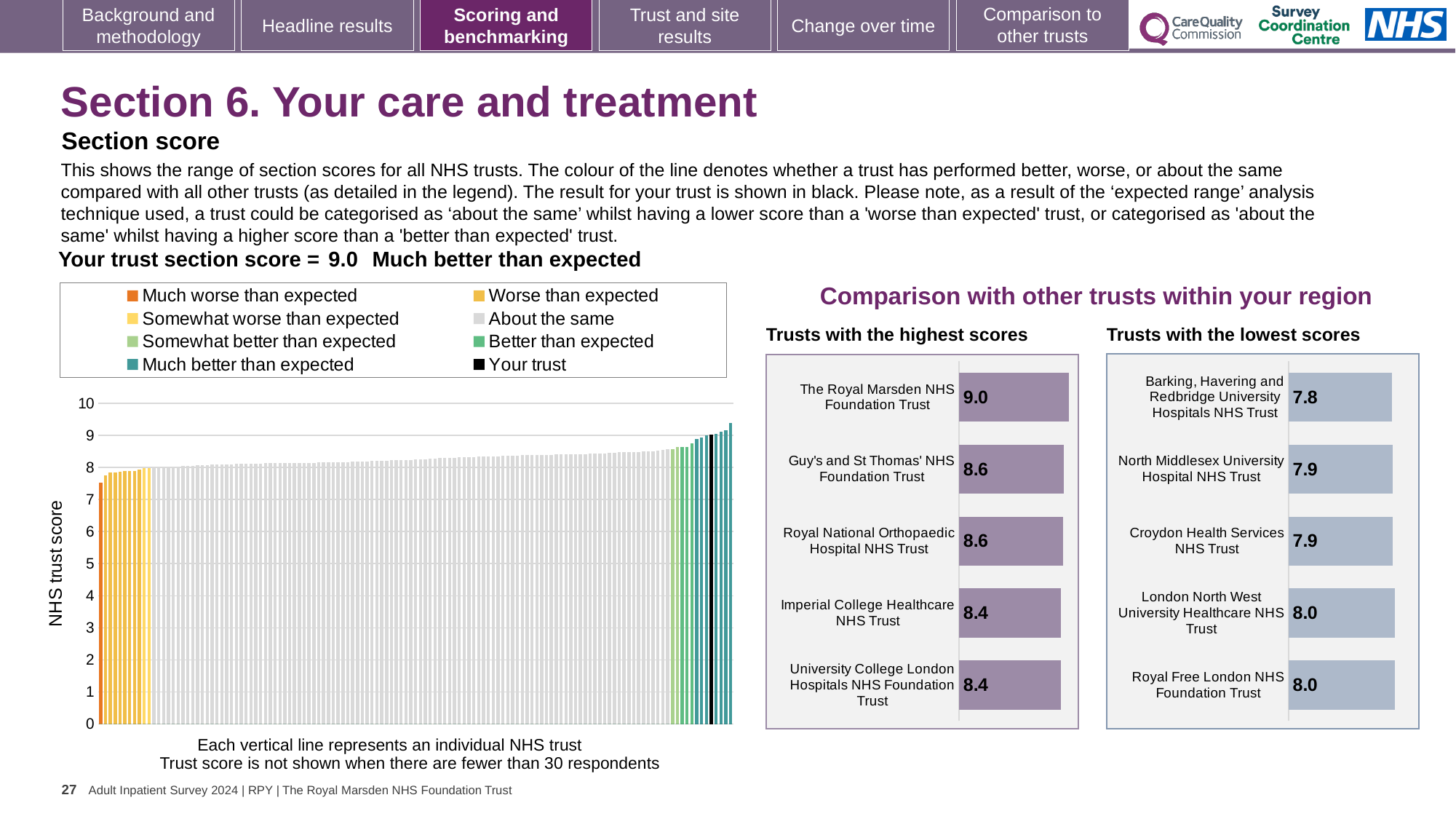
In the 'Trusts with the lowest scores' chart, what is the score for Royal Free London NHS Foundation Trust? 8.0 How many trusts are shown in the 'Trusts with the highest scores' chart? 5 How many entries does the legend of the 'NHS trust score' chart list? 8 In the 'Trusts with the highest scores' chart, what is the score for Imperial College Healthcare NHS Trust? 8.4 In the 'Trusts with the highest scores' chart, which has the larger score: Guy's and St Thomas' NHS Foundation Trust or Imperial College Healthcare NHS Trust? Guy's and St Thomas' NHS Foundation Trust In the 'Trusts with the highest scores' chart, what is the difference between the scores of The Royal Marsden NHS Foundation Trust and University College London Hospitals NHS Foundation Trust? 0.6 In the 'Trusts with the lowest scores' chart, what is the difference between the scores of Royal Free London NHS Foundation Trust and Barking, Havering and Redbridge University Hospitals NHS Trust? 0.2 In the 'NHS trust score' chart, is the value of the black 'Your trust' bar greater or less than 8? greater What kind of chart is the large 'NHS trust score' chart on the left of the slide? Bar chart In the 'Trusts with the lowest scores' chart, which trust has the lowest score? Barking, Havering and Redbridge University Hospitals NHS Trust In the 'Trusts with the highest scores' chart, which trust has the highest score? The Royal Marsden NHS Foundation Trust In the 'Trusts with the highest scores' chart, what is the score for The Royal Marsden NHS Foundation Trust? 9.0